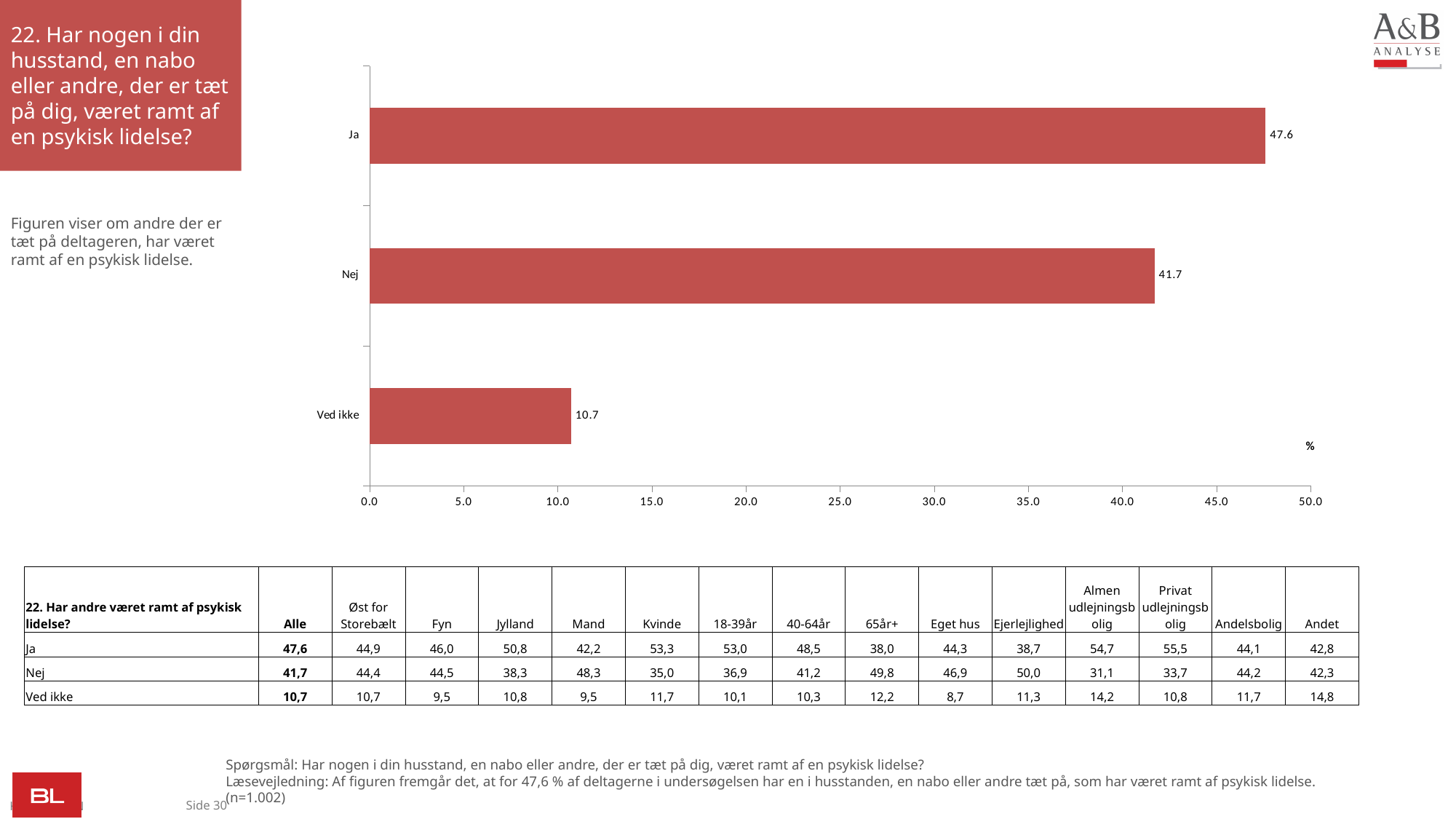
Is the value for "Nej" greater or less than 40.0? greater What is the value for "Ja" in the chart? 47.6 Which is larger, the value for "Ja" or the value for "Nej"? Ja Which category has the lowest value in the chart? Ved ikke What is the difference between the values for "Ja" and "Nej"? 5.9 What is the difference between the values for "Nej" and "Ved ikke"? 31.0 What is the maximum value shown on the x axis of the chart? 50.0 What is the value for "Nej" in the chart? 41.7 What is the value for "Ved ikke" in the chart? 10.7 What kind of chart is shown on the slide? bar chart Which category has the highest value in the chart? Ja How many categories are shown in the chart? 3